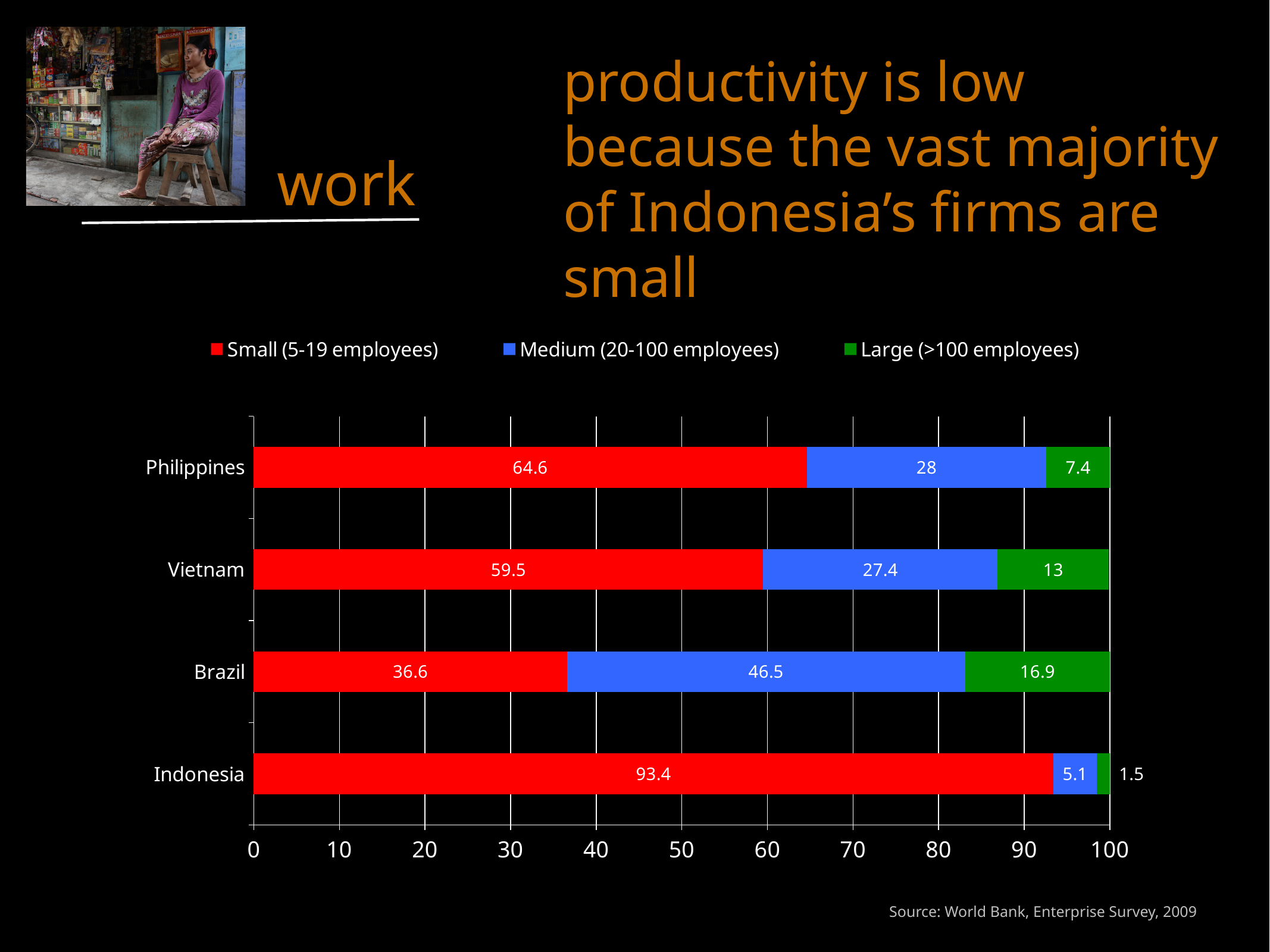
What kind of chart is shown on the slide? Stacked bar chart Which country has the lowest value for Large (>100 employees)? Indonesia How many countries are shown in the chart? 4 What is the value for Small (5-19 employees) for Indonesia? 93.4 Which is larger: the Medium (20-100 employees) value for Brazil or for Vietnam? Brazil What is the value for Medium (20-100 employees) for Brazil? 46.5 What is the value for Large (>100 employees) for Vietnam? 13 Which country has the highest value for Small (5-19 employees)? Indonesia What is the value for Large (>100 employees) for the Philippines? 7.4 What is the difference between the Small (5-19 employees) values for Indonesia and the Philippines? 28.8 How many series does the legend list? 3 What is the total of the stacked bar for Brazil? 100